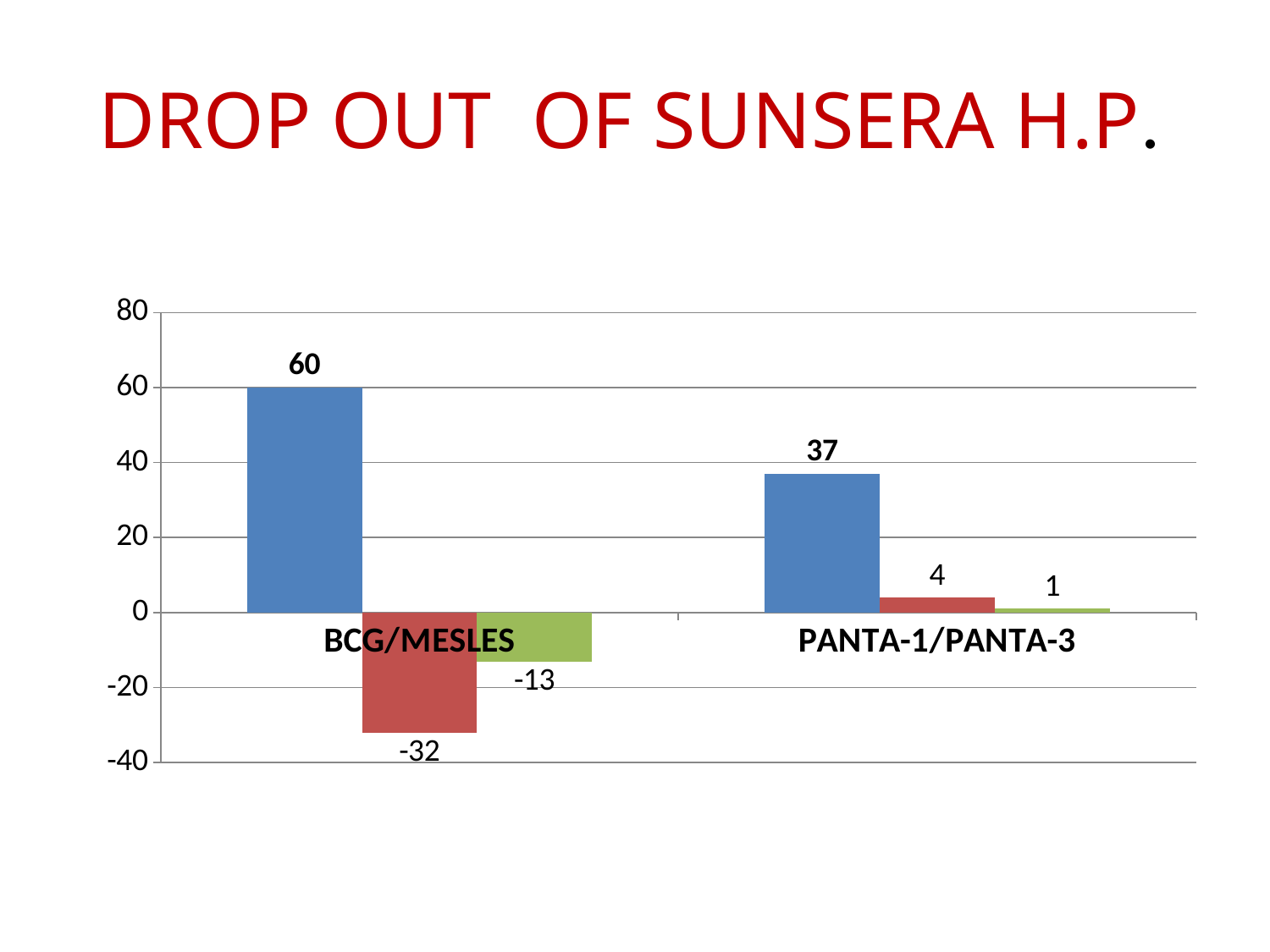
What is the value of the red bar for PANTA-1/PANTA-3? 4 What is the value of the blue bar for BCG/MESLES? 60 What is the value of the green bar for BCG/MESLES? -13 What is the value of the red bar for BCG/MESLES? -32 Which bar has the lowest value in the chart? The red bar for BCG/MESLES (-32) What is the difference between the blue bar values for BCG/MESLES and PANTA-1/PANTA-3? 23 Which category has the highest blue bar value? BCG/MESLES What is the value of the blue bar for PANTA-1/PANTA-3? 37 Which is larger: the red bar for BCG/MESLES or the red bar for PANTA-1/PANTA-3? PANTA-1/PANTA-3 What is the value of the green bar for PANTA-1/PANTA-3? 1 What type of chart is shown on the slide? Bar chart How many categories are shown on the x axis? 2